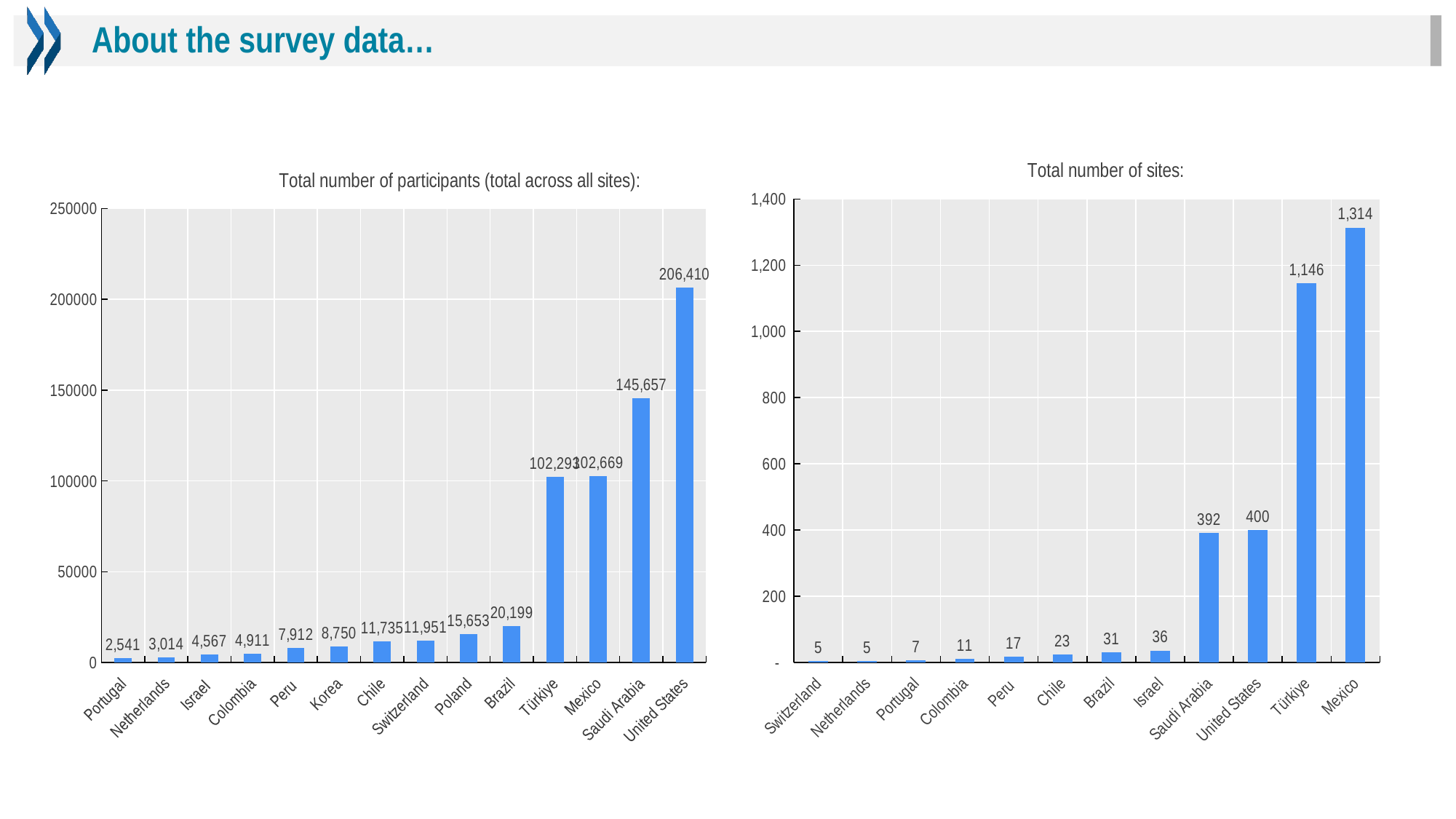
In the 'Total number of participants' chart, how many participants does the United States have? 206,410 In the 'Total number of sites' chart, how many sites does Türkiye have? 1,146 What kind of chart is the 'Total number of sites' chart? Bar chart In the 'Total number of sites' chart, how many countries are shown on the x axis? 12 In the 'Total number of participants' chart, is the value for Saudi Arabia greater or less than 150000? less In the 'Total number of participants' chart, what is the difference between Saudi Arabia and Brazil? 125,458 In the 'Total number of participants' chart, how many countries are shown on the x axis? 14 In the 'Total number of sites' chart, which has more sites, Saudi Arabia or the United States? United States In the 'Total number of participants' chart, which country has the lowest number of participants? Portugal In the 'Total number of sites' chart, what is the difference in sites between Mexico and Türkiye? 168 In the 'Total number of sites' chart, which country has the highest number of sites? Mexico In the 'Total number of participants' chart, do the values rise or fall from left to right along the x axis? Rise